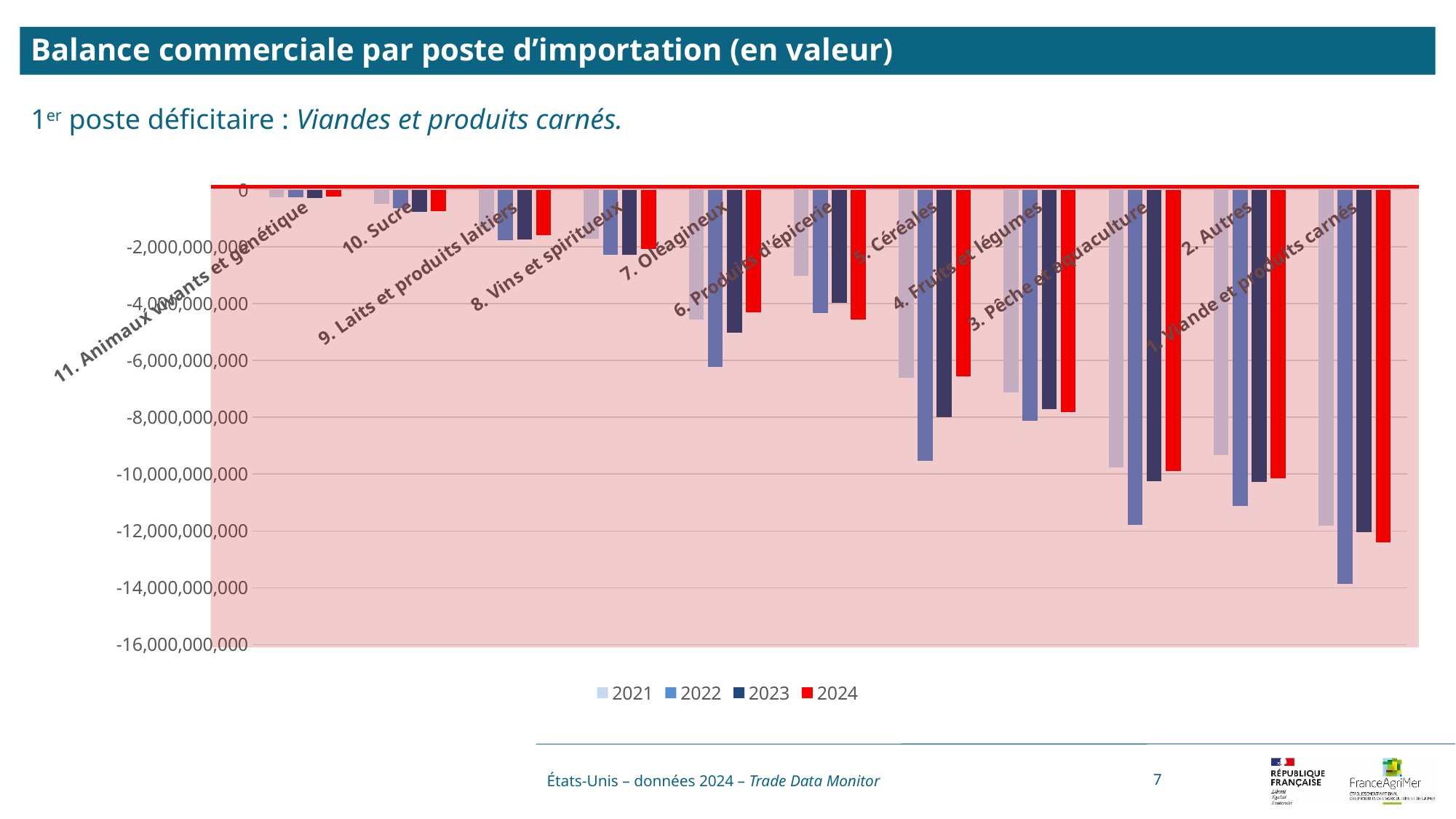
Do the deficits generally get larger or smaller moving from left to right along the x axis? larger Is the 2022 value for '1. Viande et produits carnés' greater or less than -12,000,000,000? less Is the 2024 value for '5. Céréales' greater or less than -6,000,000,000? less Which category has the lowest (most negative) bar in the chart overall? 1. Viande et produits carnés How many series does the chart legend list? 4 Is the 2023 value for '7. Oléagineux' greater or less than -4,000,000,000? less For '1. Viande et produits carnés', which year has the larger deficit, 2022 or 2024? 2022 Which category has the bars closest to zero (smallest deficit)? 11. Animaux vivants et génétique How many import categories are shown on the x axis of the chart? 11 Which colour represents the 2024 series in the chart? red What kind of chart is shown on the slide? bar chart